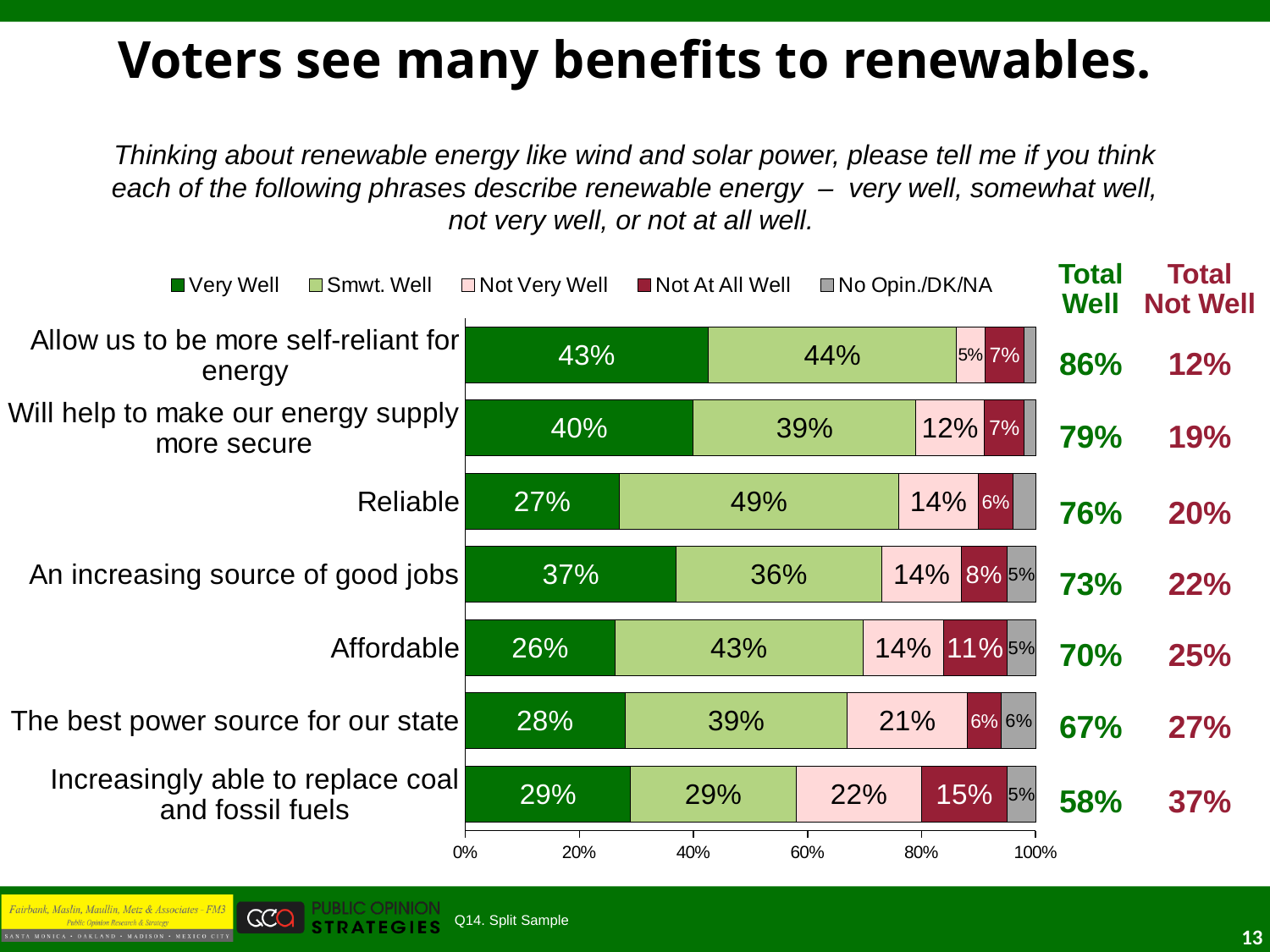
Which phrase has the lowest "Very Well" percentage? Affordable How many phrases (categories) are plotted in the chart? 7 What percentage of voters said "Very Well" describes renewable energy as "Reliable"? 27% What type of chart is shown on the slide? Stacked bar chart Which phrase has the highest "Very Well" percentage? Allow us to be more self-reliant for energy How many percentage points higher is the "Smwt. Well" value for "Reliable" than for "Affordable"? 6 percentage points What is the combined "Very Well" and "Smwt. Well" total for "Affordable"? 70% What is the "Not Very Well" value for "The best power source for our state"? 21% How many series does the legend list? 5 Which has a larger "Very Well" share: "An increasing source of good jobs" or "Will help to make our energy supply more secure"? Will help to make our energy supply more secure What is the "Total Not Well" figure shown for "Increasingly able to replace coal and fossil fuels"? 37% Which phrase has the highest "Not At All Well" percentage? Increasingly able to replace coal and fossil fuels